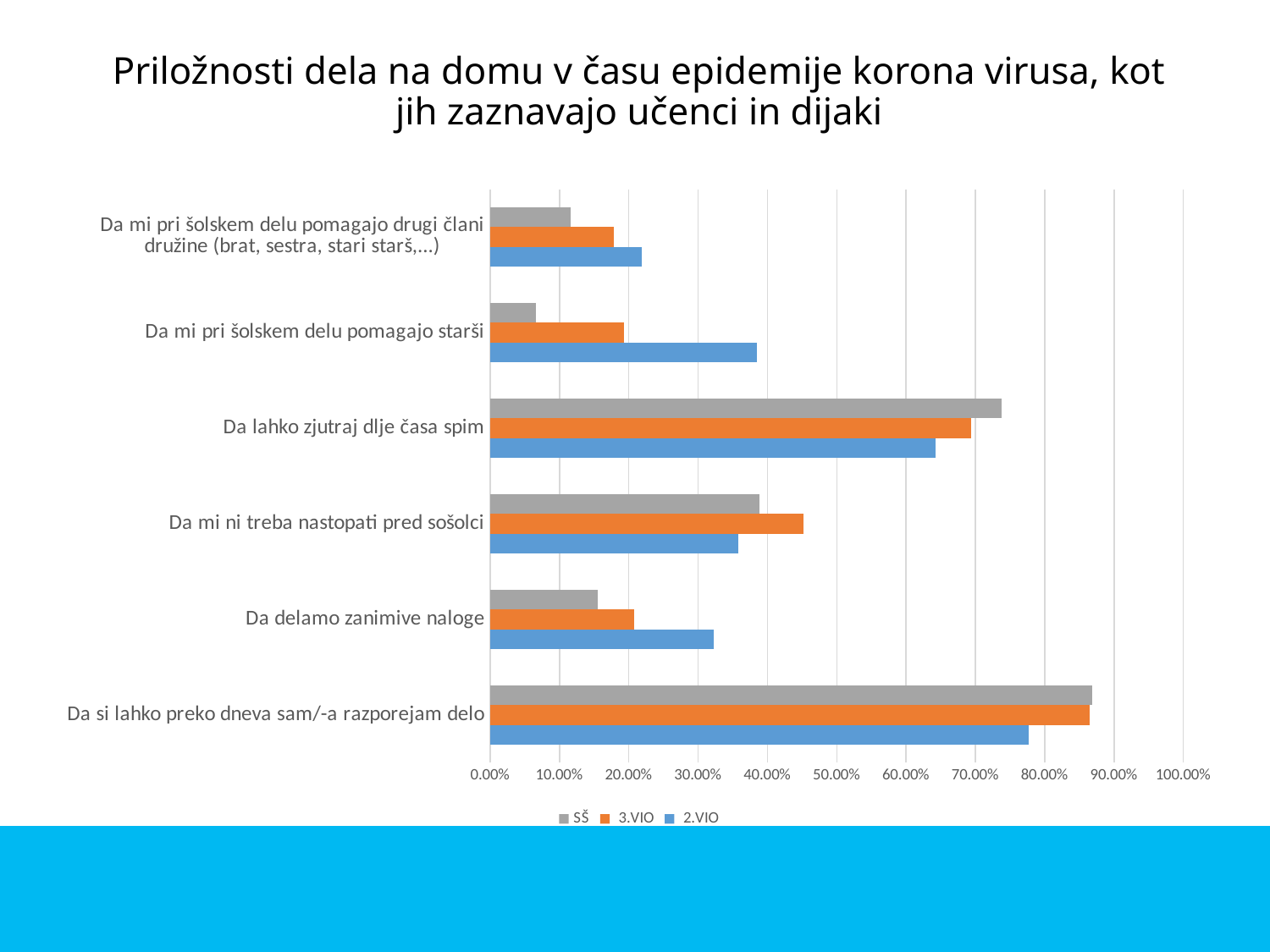
Is the 2.VIO value for "Da mi pri šolskem delu pomagajo starši" greater or less than 30.00%? greater Which series are listed in the legend? SŠ, 3.VIO, 2.VIO Is the 3.VIO value for "Da lahko zjutraj dlje časa spim" greater or less than 60.00%? greater Which category has the lowest SŠ value? Da mi pri šolskem delu pomagajo starši Is the SŠ value for "Da si lahko preko dneva sam/-a razporejam delo" greater or less than 80.00%? greater For "Da delamo zanimive naloge", which series has the larger value: SŠ or 2.VIO? 2.VIO How many categories are shown on the chart? 6 How many series does the legend list? 3 What kind of chart is shown on the slide? bar chart What is the title of the chart? Priložnosti dela na domu v času epidemije korona virusa, kot jih zaznavajo učenci in dijaki Which category has the highest SŠ value? Da si lahko preko dneva sam/-a razporejam delo